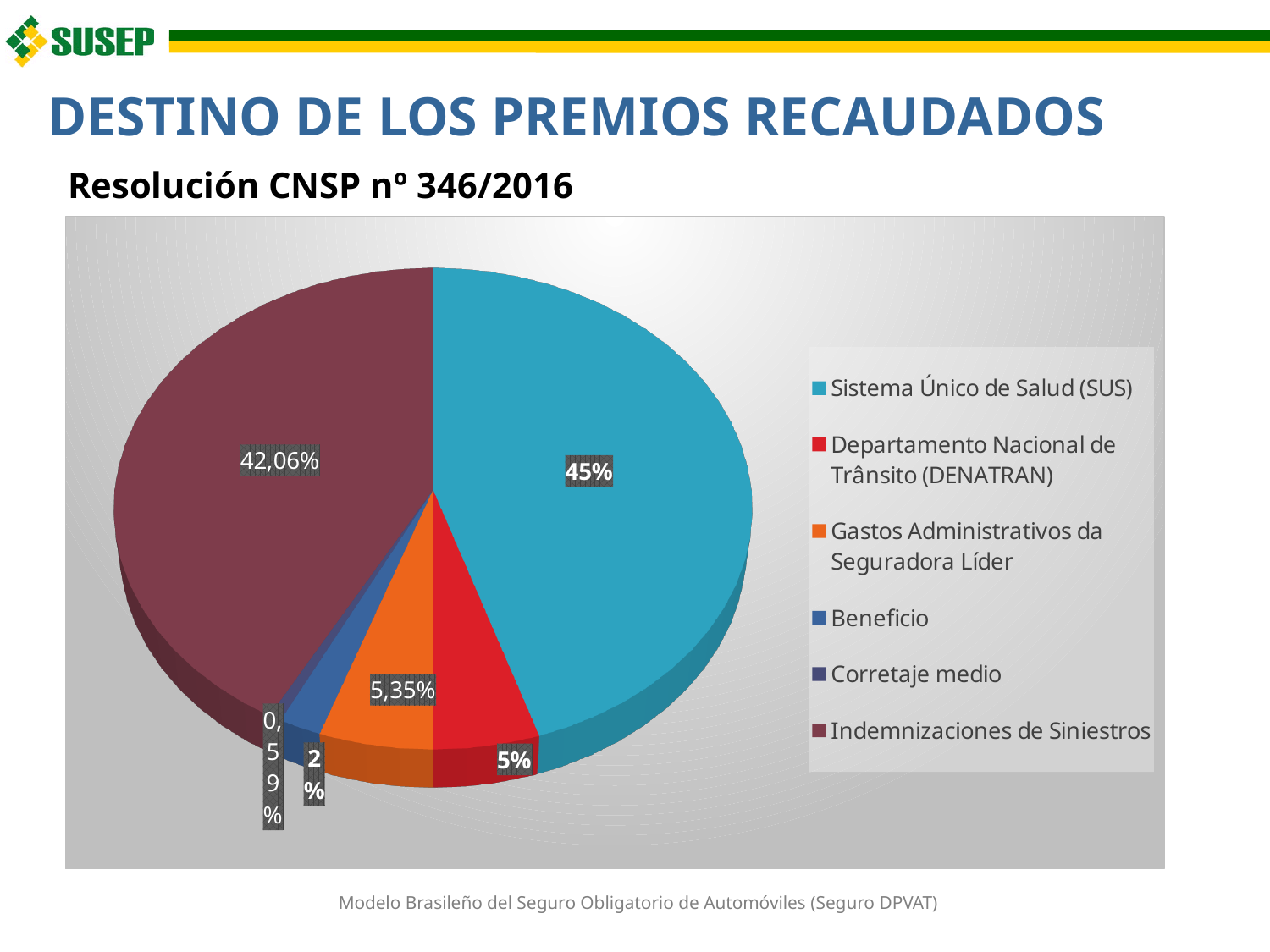
Which is larger: the share for Gastos Administrativos da Seguradora Líder or the share for Beneficio? Gastos Administrativos da Seguradora Líder How many categories does the legend list? 6 Which category has the largest slice of the pie? Sistema Único de Salud (SUS) What is the value shown for Gastos Administrativos da Seguradora Líder? 5,35% What type of chart is shown on the slide? Pie chart What is the value shown for Departamento Nacional de Trânsito (DENATRAN)? 5% What share of the pie does Indemnizaciones de Siniestros represent? 42,06% What is the difference between the shares of Sistema Único de Salud (SUS) and Indemnizaciones de Siniestros? 2,94% Which category has the smallest slice of the pie? Corretaje medio What share of the pie does Sistema Único de Salud (SUS) represent? 45% What colour is the slice for Indemnizaciones de Siniestros? Maroon (dark red) What is the value shown for Corretaje medio? 0,59%